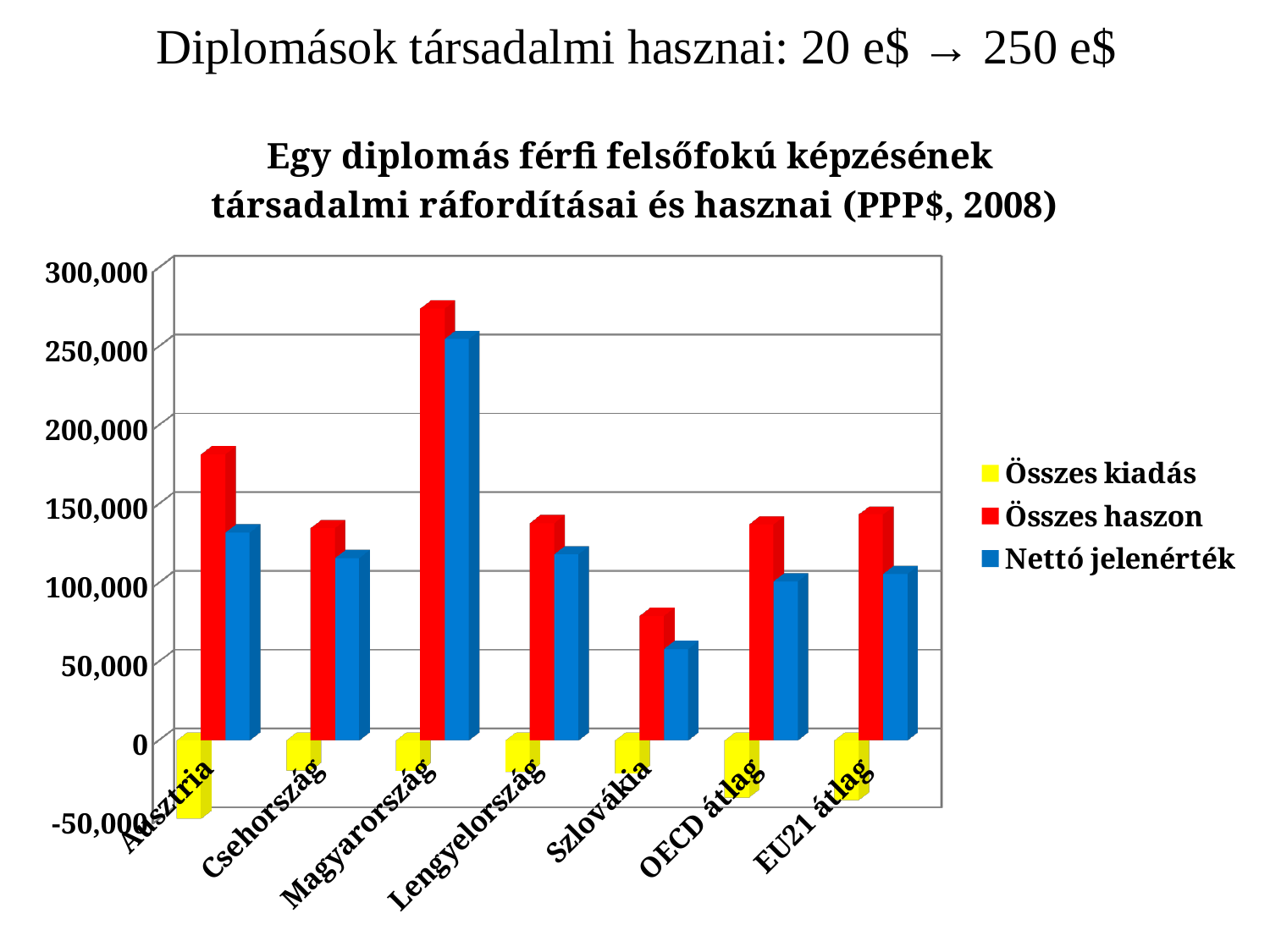
Which category has the lowest Nettó jelenérték value? Szlovákia What kind of chart is shown on the slide? Bar chart Is the Összes haszon value for Szlovákia greater or less than 100,000? less How many series does the legend list? 3 How many countries or averages are shown on the x axis? 7 Which series is shown in yellow in the legend? Összes kiadás Which has the larger Összes haszon value, Ausztria or Csehország? Ausztria Which category has the lowest Összes haszon value? Szlovákia Which category has the highest Nettó jelenérték value? Magyarország Is the Összes haszon value for Magyarország greater or less than 250,000? greater Which category has the highest Összes haszon value? Magyarország Is the Nettó jelenérték value for Ausztria greater or less than 100,000? greater